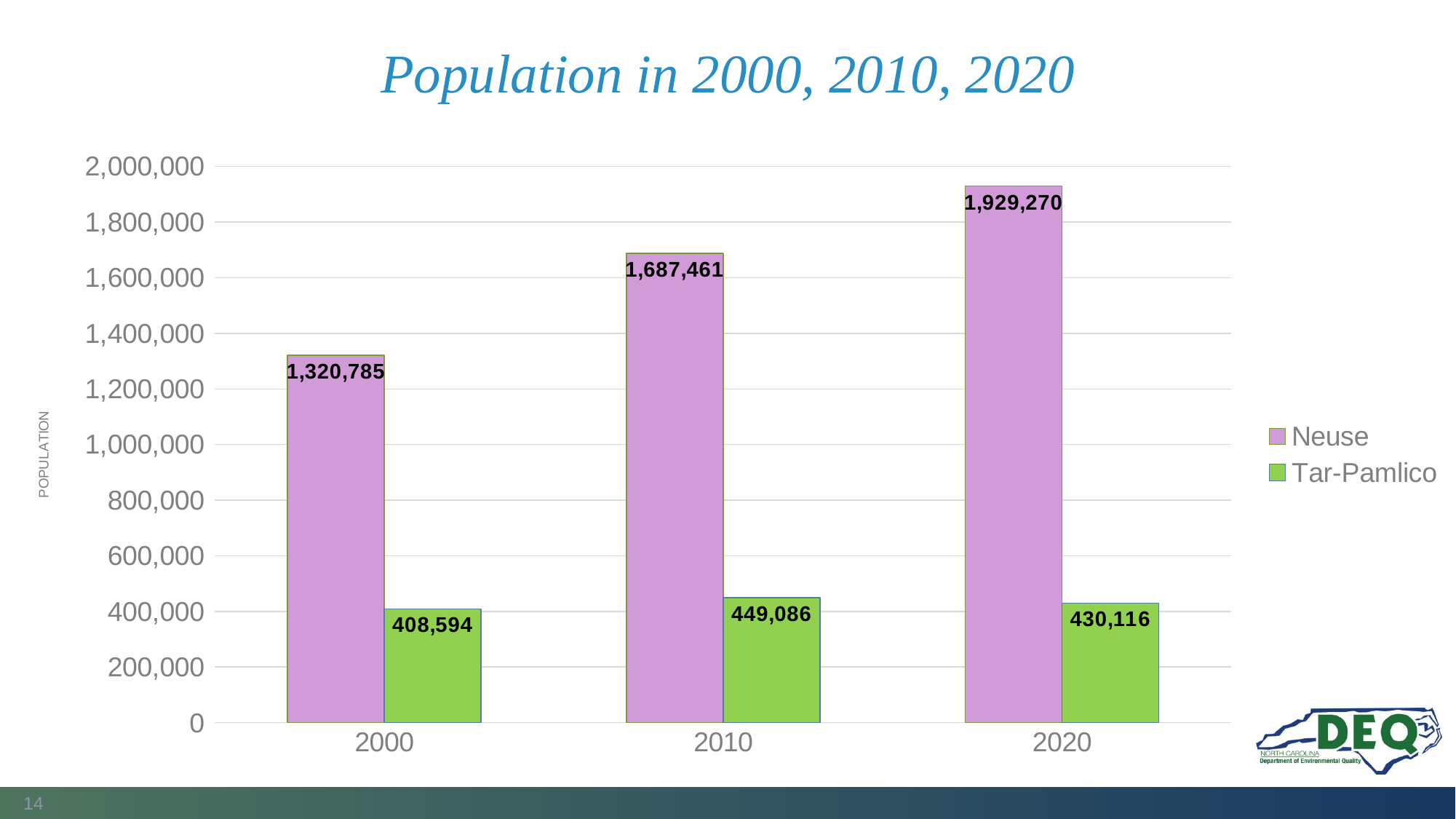
What is the Neuse population in 2020? 1,929,270 What is the difference between the Neuse population in 2020 and in 2010? 241,809 How many series does the legend list? 2 Does the Neuse population rise or fall from 2000 to 2020? rise In which year is the Tar-Pamlico population highest? 2010 What is the Neuse population in 2010? 1,687,461 In which year is the Neuse population lowest? 2000 Which is larger: the Tar-Pamlico population in 2000 or in 2020? 2020 Is the Neuse population in 2000 greater or less than 1,400,000? less How many years are shown on the x axis? 3 What is the difference between the Tar-Pamlico population in 2010 and in 2020? 18,970 What is the Tar-Pamlico population in 2000? 408,594